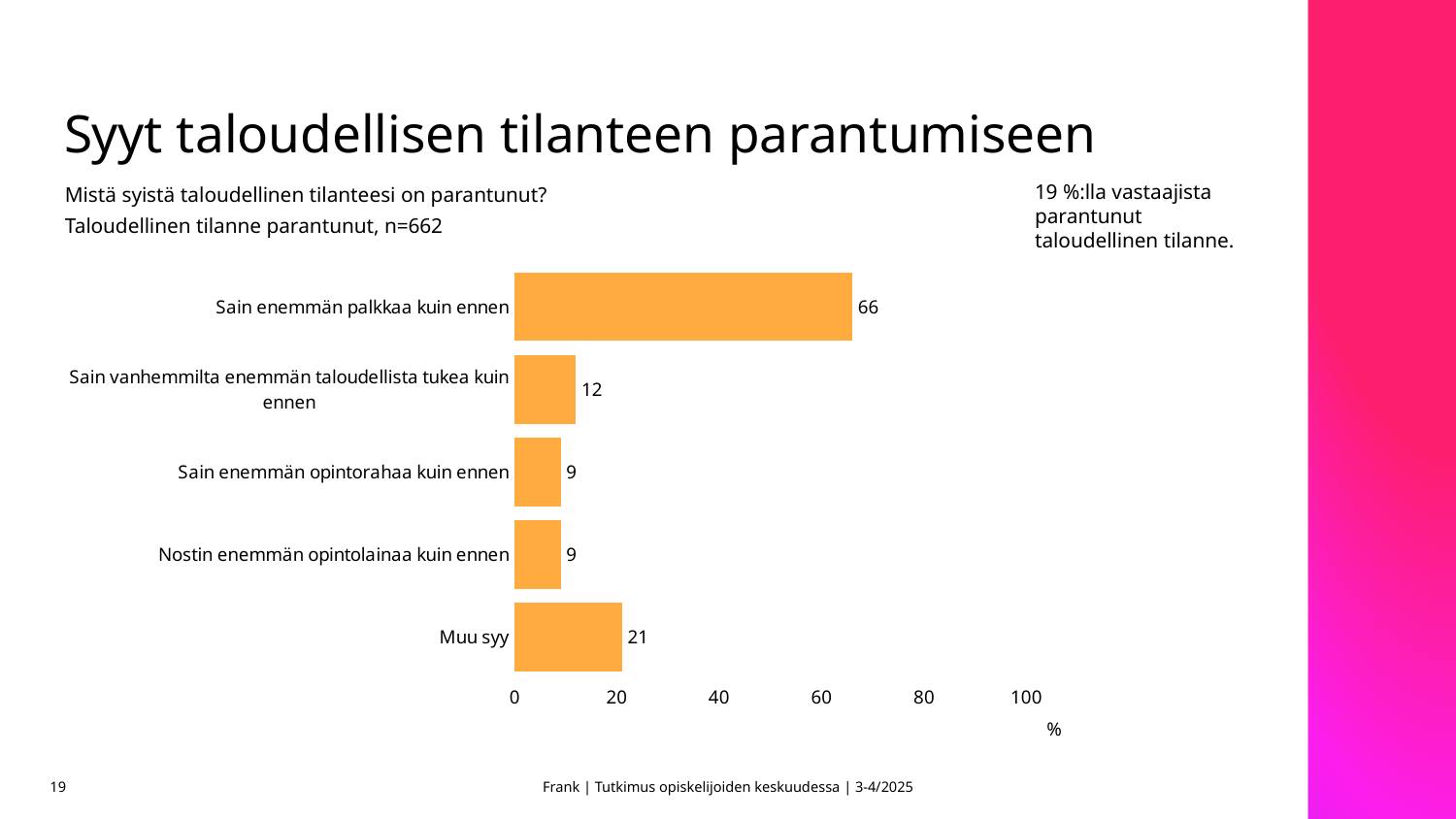
What is the difference between the values for "Sain vanhemmilta enemmän taloudellista tukea kuin ennen" and "Sain enemmän opintorahaa kuin ennen"? 3 Which category has the highest value? Sain enemmän palkkaa kuin ennen Is the value for "Sain enemmän palkkaa kuin ennen" greater or less than 60? greater What is the value for "Nostin enemmän opintolainaa kuin ennen"? 9 What is the value for "Sain enemmän palkkaa kuin ennen"? 66 What is the sample size (n) stated for the chart? n=662 What is the value for "Muu syy"? 21 What is the difference between the values for "Sain enemmän palkkaa kuin ennen" and "Muu syy"? 45 Which is larger, the value for "Muu syy" or the value for "Sain vanhemmilta enemmän taloudellista tukea kuin ennen"? Muu syy What is the value for "Sain vanhemmilta enemmän taloudellista tukea kuin ennen"? 12 How many categories are shown in the chart? 5 What kind of chart is shown on the slide? bar chart